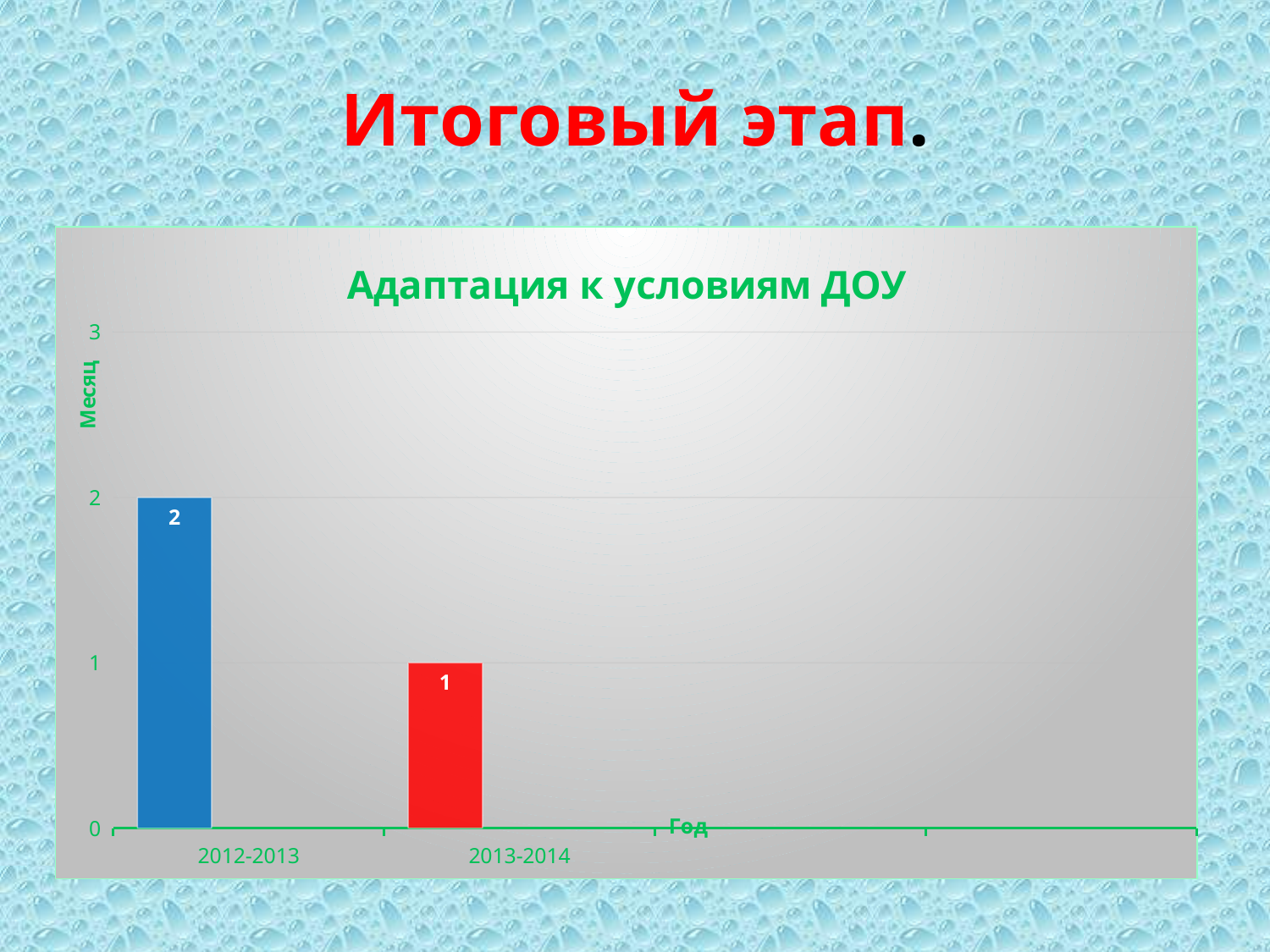
Which category has the highest value? 2012-2013 How many categories are shown on the x axis with bars? 2 Which is larger, the value for 2012-2013 or the value for 2013-2014? 2012-2013 What is the value for 2013-2014? 1 Do the values rise or fall from 2012-2013 to 2013-2014? fall Which category has the lowest value? 2013-2014 What is the difference between the values for 2012-2013 and 2013-2014? 1 What kind of chart is shown on the slide? bar chart What is the label of the vertical axis? Месяц What is the title of the chart? Адаптация к условиям ДОУ What is the value for 2012-2013? 2